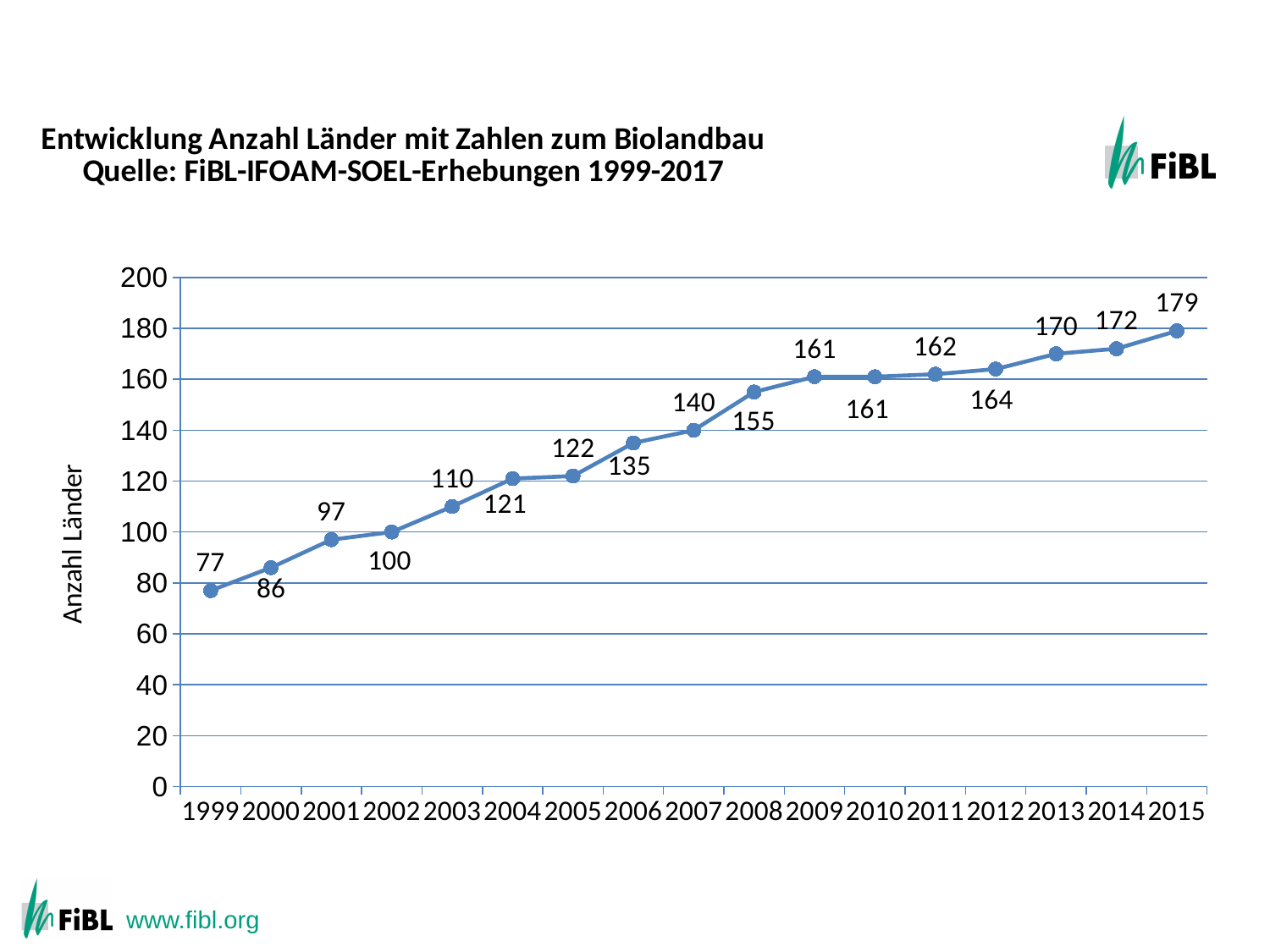
How many years are shown on the x axis? 17 What kind of chart is this? line chart What is the value for 2008? 155 What is the value for 2015? 179 What is the label of the y axis? Anzahl Länder Do the values rise or fall from 1999 to 2015? rise Which is larger, the value for 2006 or the value for 2007? 2007 What is the value for 1999? 77 What is the value for 2003? 110 Which year has the lowest value? 1999 What is the difference between the values for 2015 and 1999? 102 Which year has the highest value? 2015